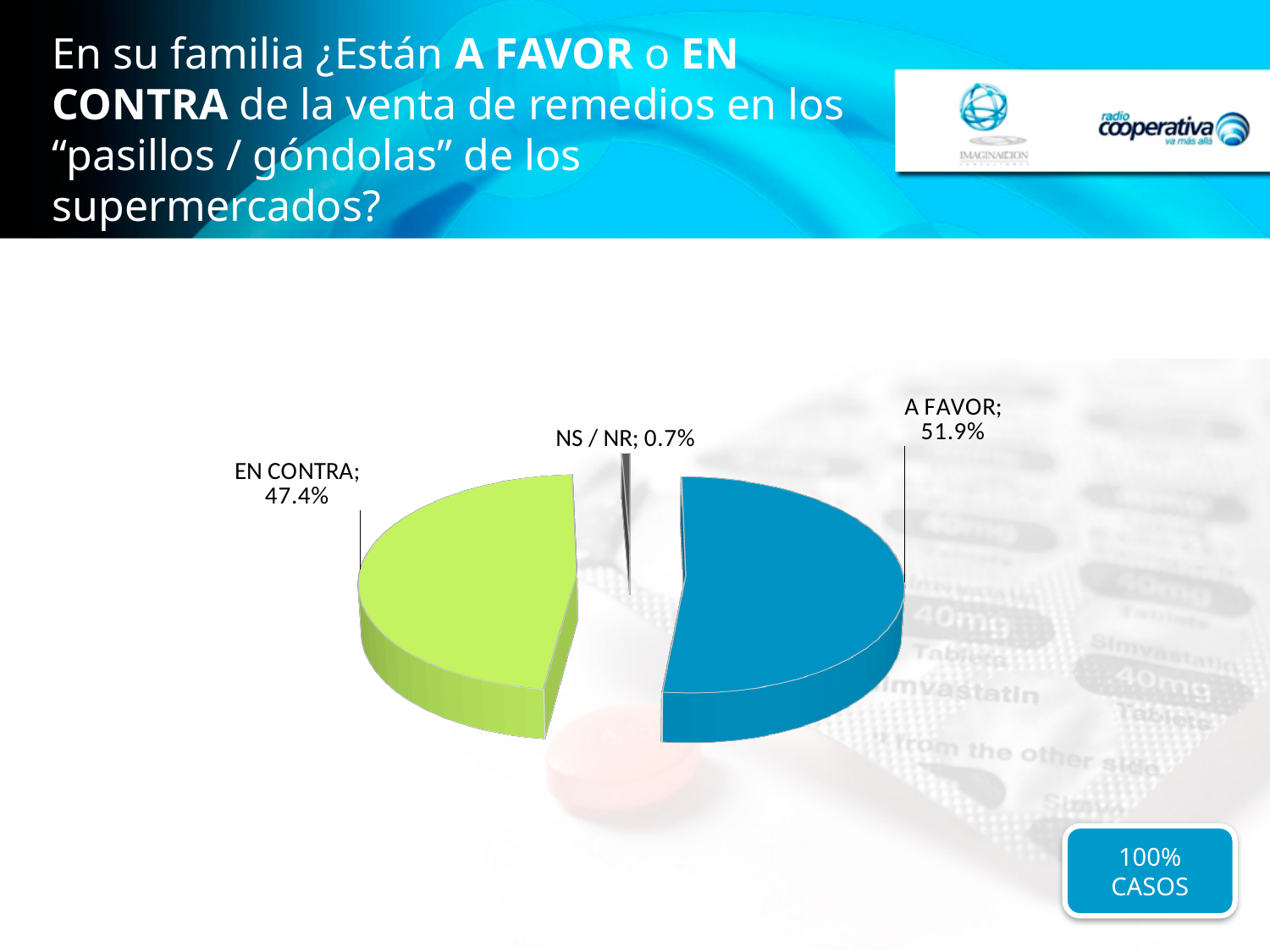
What is the difference in percentage points between A FAVOR and EN CONTRA? 4.5 How many categories are shown in the pie chart? 3 What percentage of respondents answered A FAVOR? 51.9% Which category has the largest share of the pie? A FAVOR What percentage of respondents answered EN CONTRA? 47.4% Which is larger, the share for A FAVOR or the share for EN CONTRA? A FAVOR What percentage of respondents answered NS / NR? 0.7% Which category has the smallest share of the pie? NS / NR What colour is the A FAVOR slice? Blue What kind of chart is shown on the slide? Pie chart What colour is the EN CONTRA slice? Green What is the combined share of A FAVOR and EN CONTRA? 99.3%